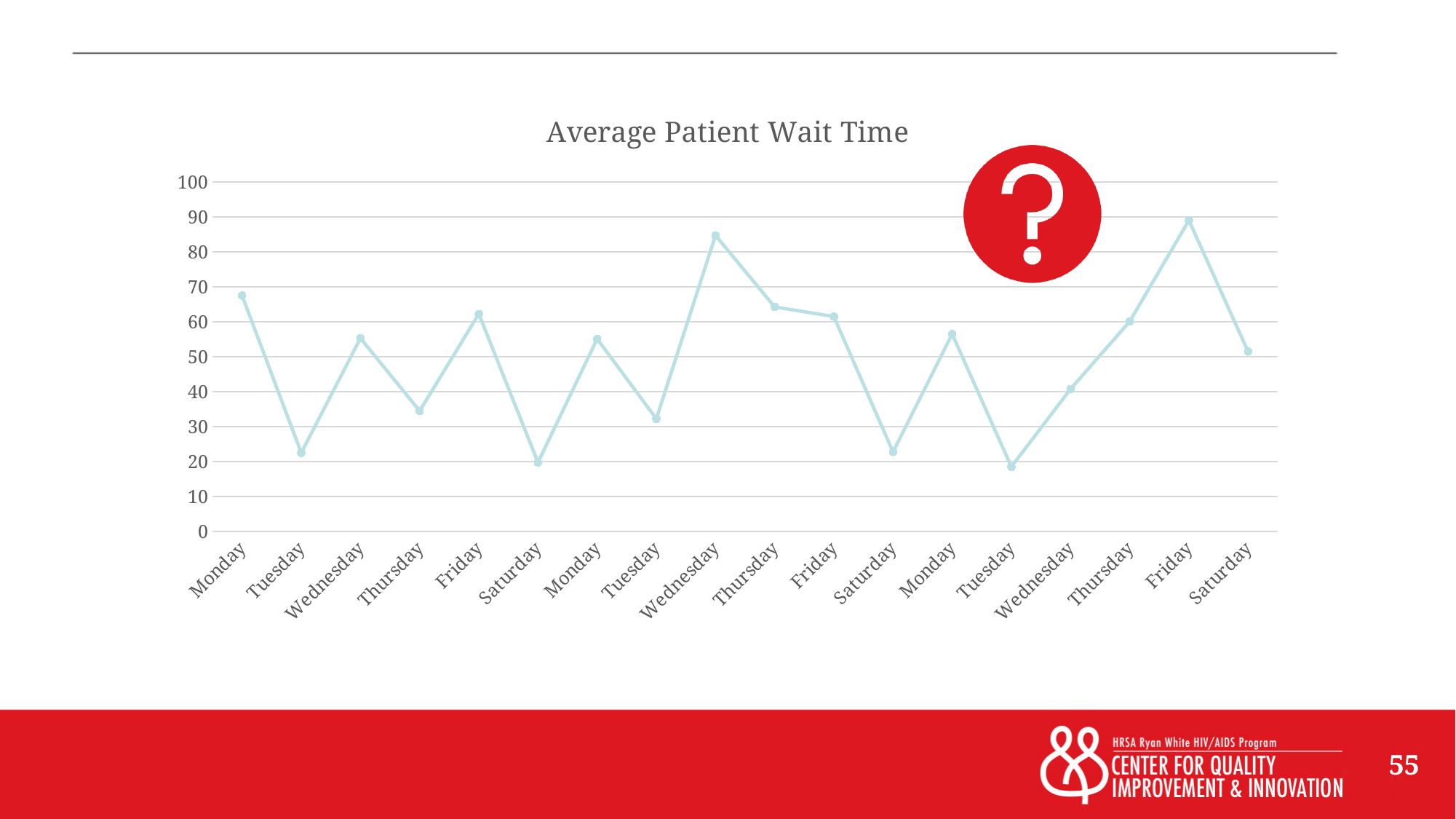
Is the value for the first Tuesday greater or less than 30? less Does the line rise or fall from the third Wednesday to the third Friday? rise Which has the higher value, the third Wednesday or the third Thursday? Thursday Is the value for the first Monday greater or less than 60? greater Which has the higher value, the first Monday or the first Tuesday? Monday Is the value for the third Friday greater or less than 80? greater How many data points are plotted on the line? 18 What is the title of the chart? Average Patient Wait Time Which has the higher value, the second Wednesday or the second Thursday? Wednesday What kind of chart is shown on the slide? line chart